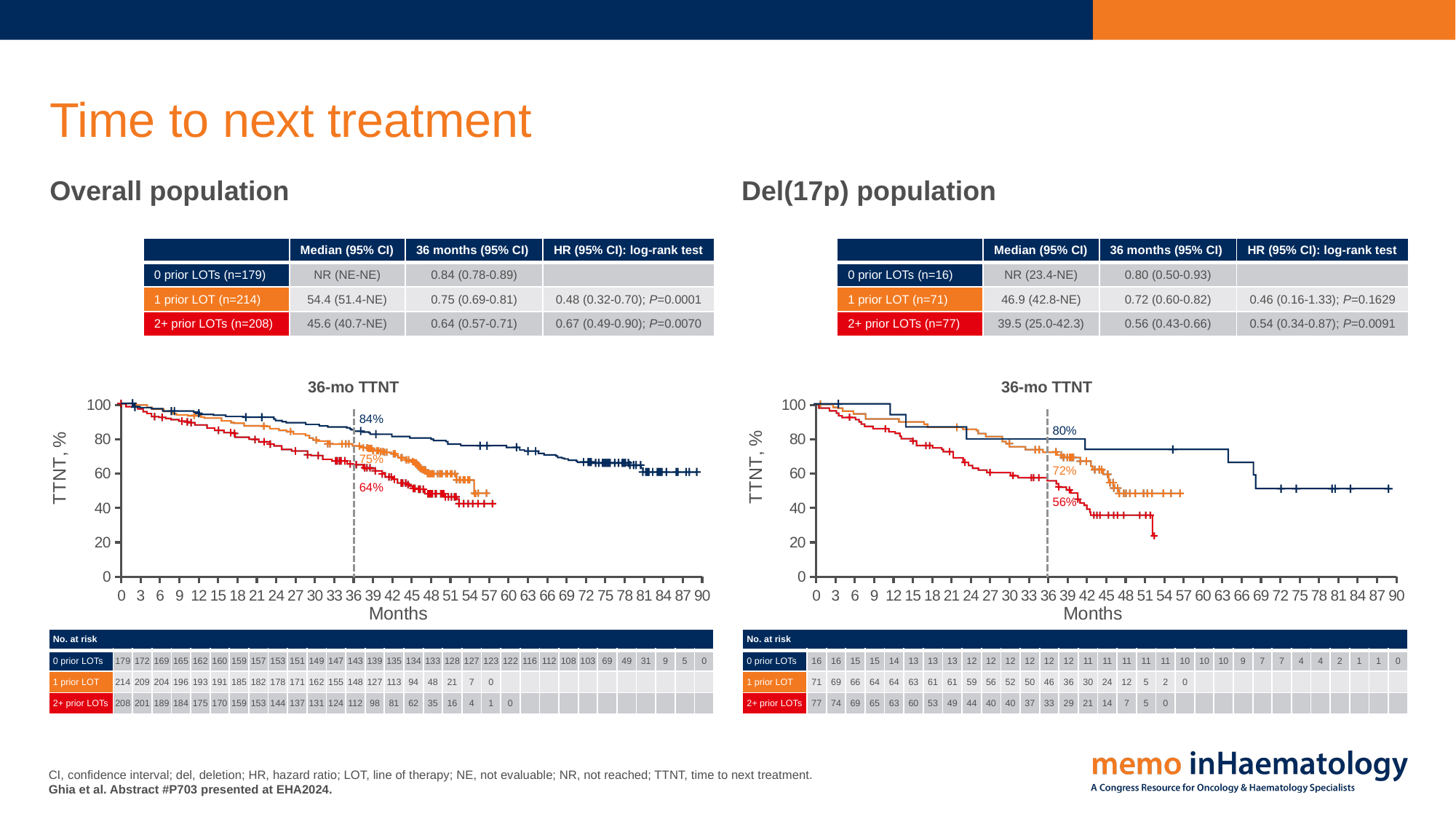
In the Overall population chart, what is the 36-month TTNT value labelled for the 2+ prior LOTs curve? 64% Is the 36-month TTNT value for 1 prior LOT larger in the Overall population chart or the Del(17p) population chart? Overall population In the Overall population chart, which group has the lowest 36-month TTNT value at the dashed line? 2+ prior LOTs In the Overall population chart, what is the 36-month TTNT value labelled for the 0 prior LOTs curve? 84% In the Del(17p) population chart, what is the 36-month TTNT value labelled for the 1 prior LOT curve? 72% In the Overall population chart, what is the number at risk for 1 prior LOT at month 0? 214 In the Overall population chart, what is the difference between the 36-month TTNT values for 0 prior LOTs and 2+ prior LOTs? 20% In the Del(17p) population chart, what is the 36-month TTNT value labelled for the 2+ prior LOTs curve? 56% In the Overall population chart, how many curves are plotted? 3 In the Del(17p) population chart, which group has the highest 36-month TTNT value at the dashed line? 0 prior LOTs In the Del(17p) population chart, do the TTNT curves rise or fall as months increase? fall In the Del(17p) population chart, what is the difference between the 36-month TTNT values for 1 prior LOT and 2+ prior LOTs? 16%